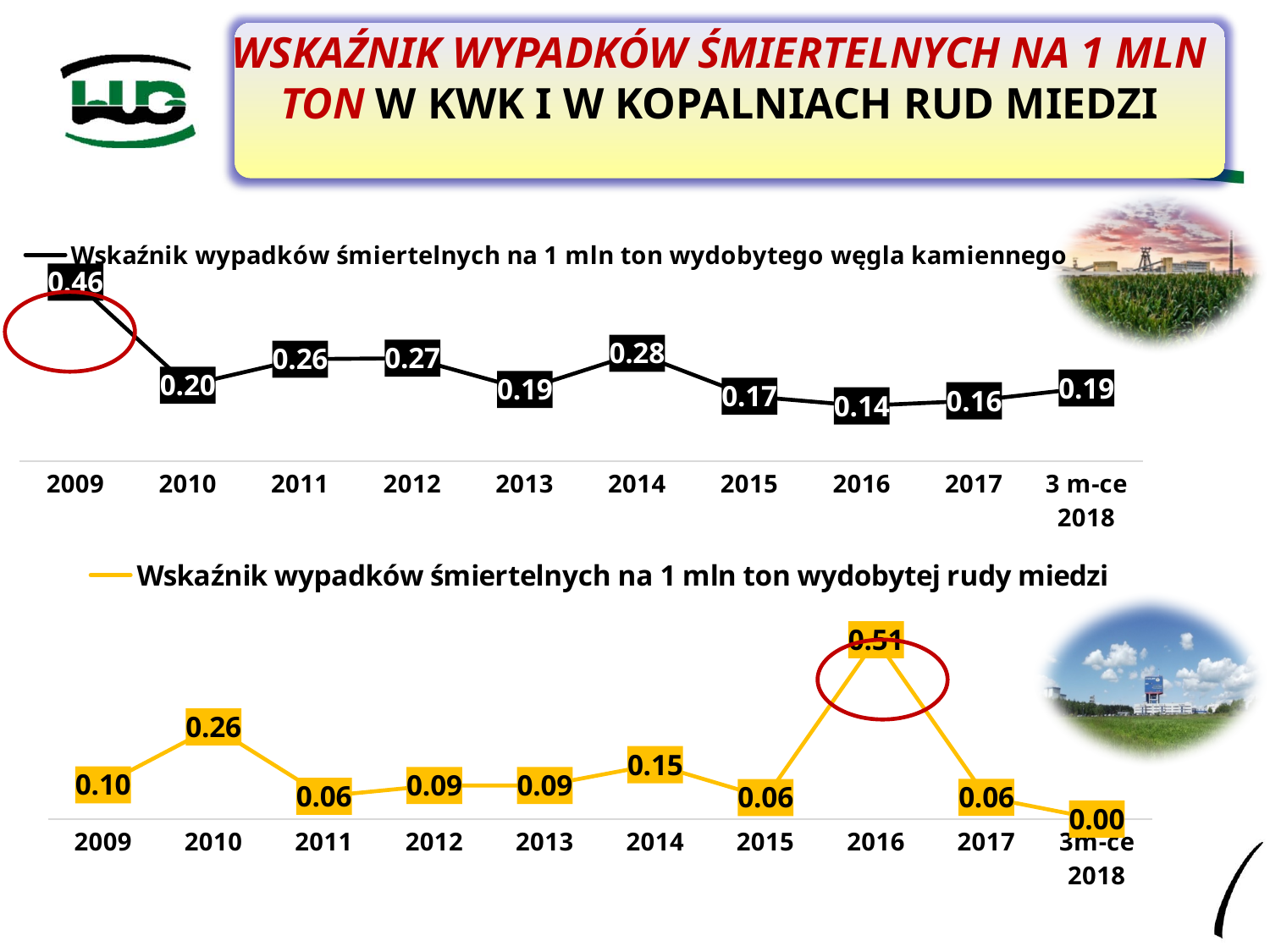
In the bottom chart (copper ore fatality rate), what is the value for 3 m-ce 2018? 0.00 In the top chart (coal mining fatality rate), what is the value for 2009? 0.46 In the top chart (coal mining fatality rate), which year has the lowest value? 2016 What type of chart is the bottom chart (copper ore fatality rate)? Line chart In the bottom chart (copper ore fatality rate), which year has the highest value? 2016 In the top chart (coal mining fatality rate), what is the difference between the 2009 value and the 2010 value? 0.26 In the bottom chart (copper ore fatality rate), does the value rise or fall from 2016 to 2017? Fall In the bottom chart (copper ore fatality rate), what is the value for 2016? 0.51 How many data points are plotted in the top chart (coal mining fatality rate)? 10 In the bottom chart (copper ore fatality rate), which is larger, the value for 2010 or the value for 2014? 2010 In the top chart (coal mining fatality rate), what is the value for 2016? 0.14 In the top chart (coal mining fatality rate), which year has the highest value? 2009